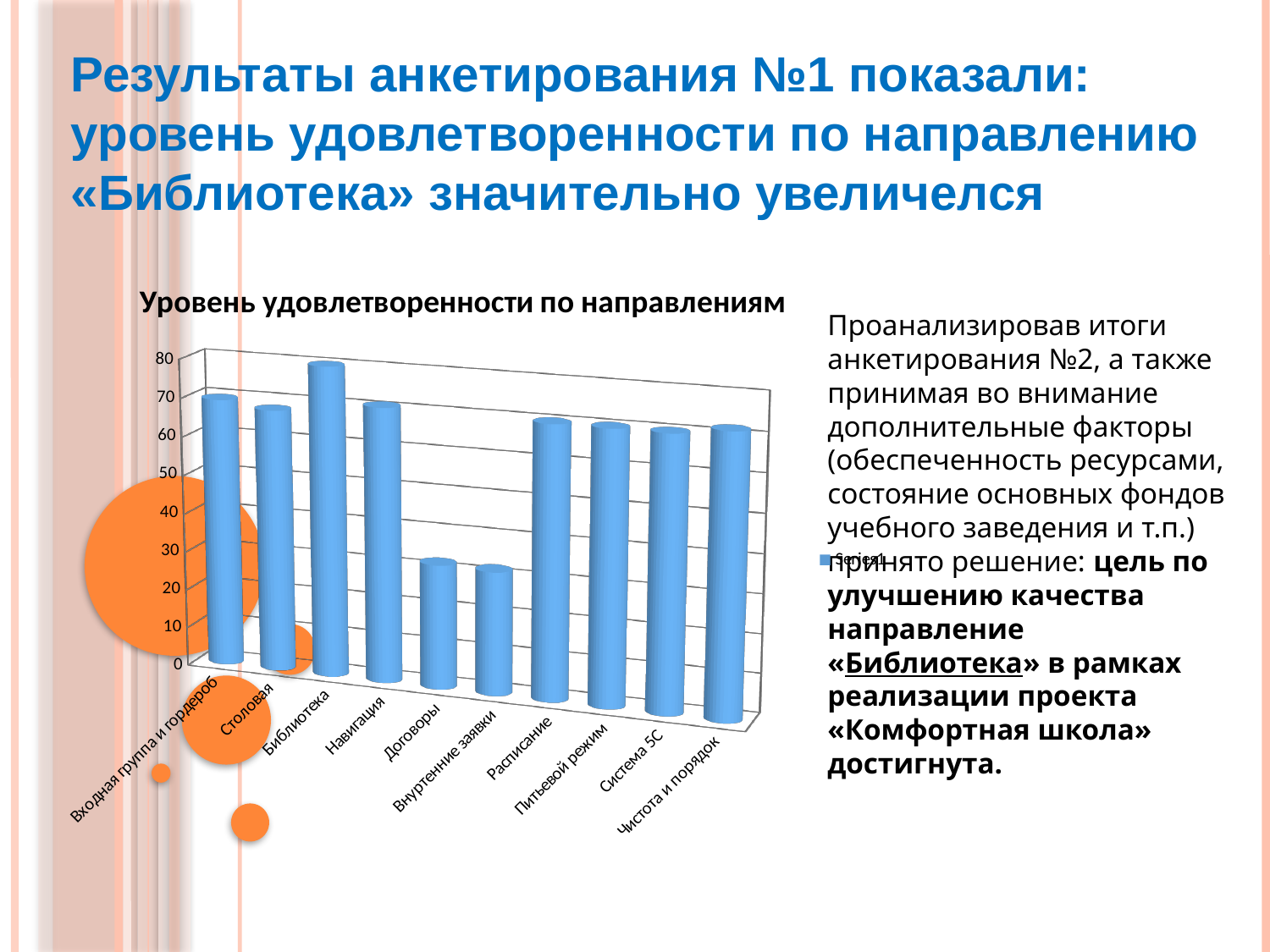
What kind of chart is shown on the slide? bar chart Which category has the highest value in the chart? Библиотека Which is larger, the value for Навигация or the value for Внутренние заявки? Навигация Is the value for Входная группа и гардероб greater or less than 50? greater What is the title of the chart? Уровень удовлетворенности по направлениям Is the value for Договоры greater or less than 40? less Which is larger, the value for Библиотека or the value for Столовая? Библиотека Is the value for Внутренние заявки greater or less than 40? less How many categories are shown on the x axis of the chart? 10 Which is larger, the value for Договоры or the value for Расписание? Расписание